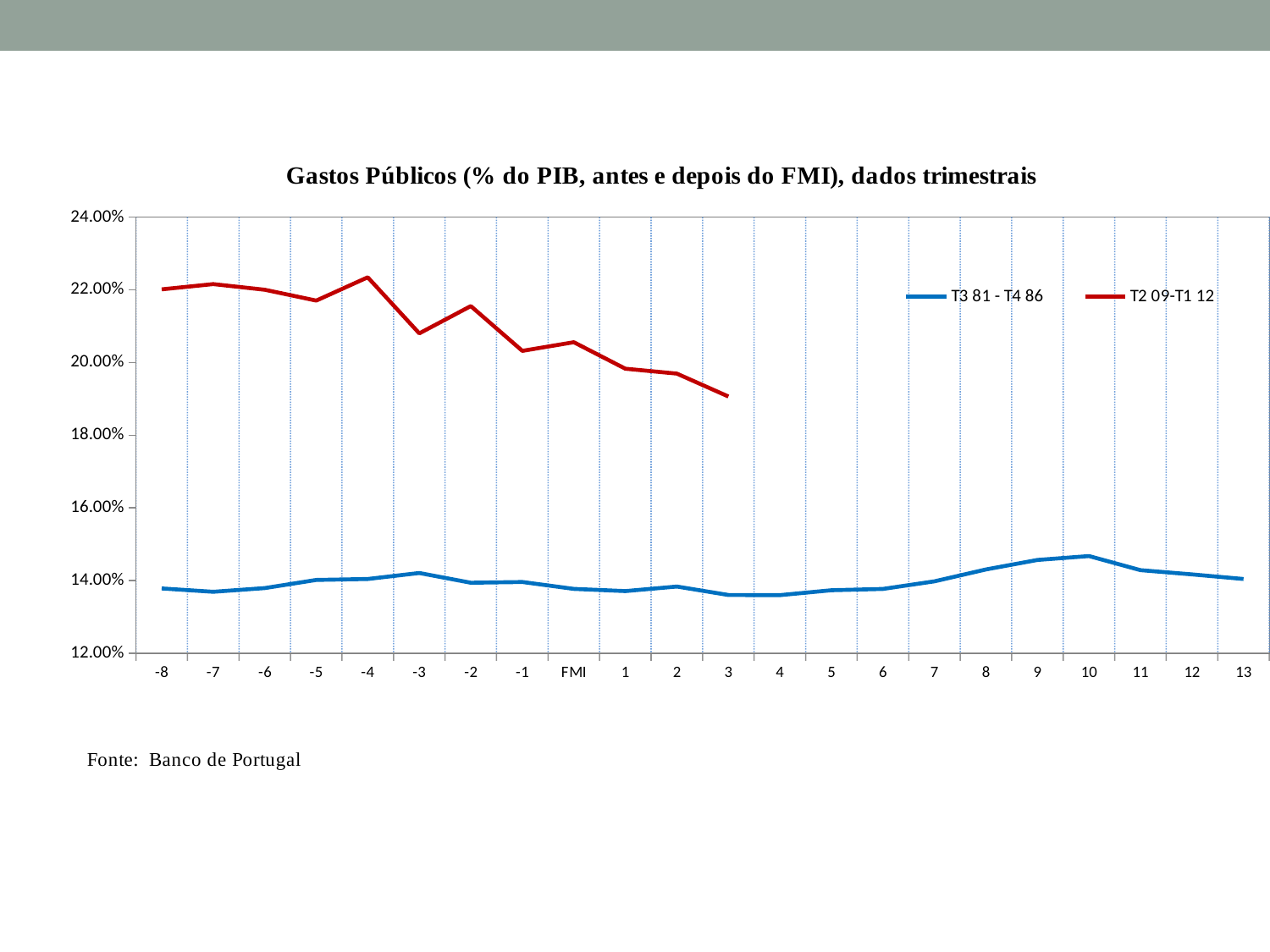
Is the value of the T3 81 - T4 86 series at 4 greater or less than 14.00%? less How many series does the legend list? 2 How many points are labelled along the x axis? 22 At which x-axis point does the T2 09-T1 12 series reach its highest value? -4 Which series is drawn in red? T2 09-T1 12 What kind of chart is shown on the slide? line chart Is the value of the T3 81 - T4 86 series at 10 greater or less than 14.00%? greater Is the value of the T2 09-T1 12 series at 3 greater or less than 20.00%? less Which series has the higher value at the FMI point, T3 81 - T4 86 or T2 09-T1 12? T2 09-T1 12 At which x-axis point does the T2 09-T1 12 series reach its lowest value? 3 What is the title of the chart? Gastos Públicos (% do PIB, antes e depois do FMI), dados trimestrais